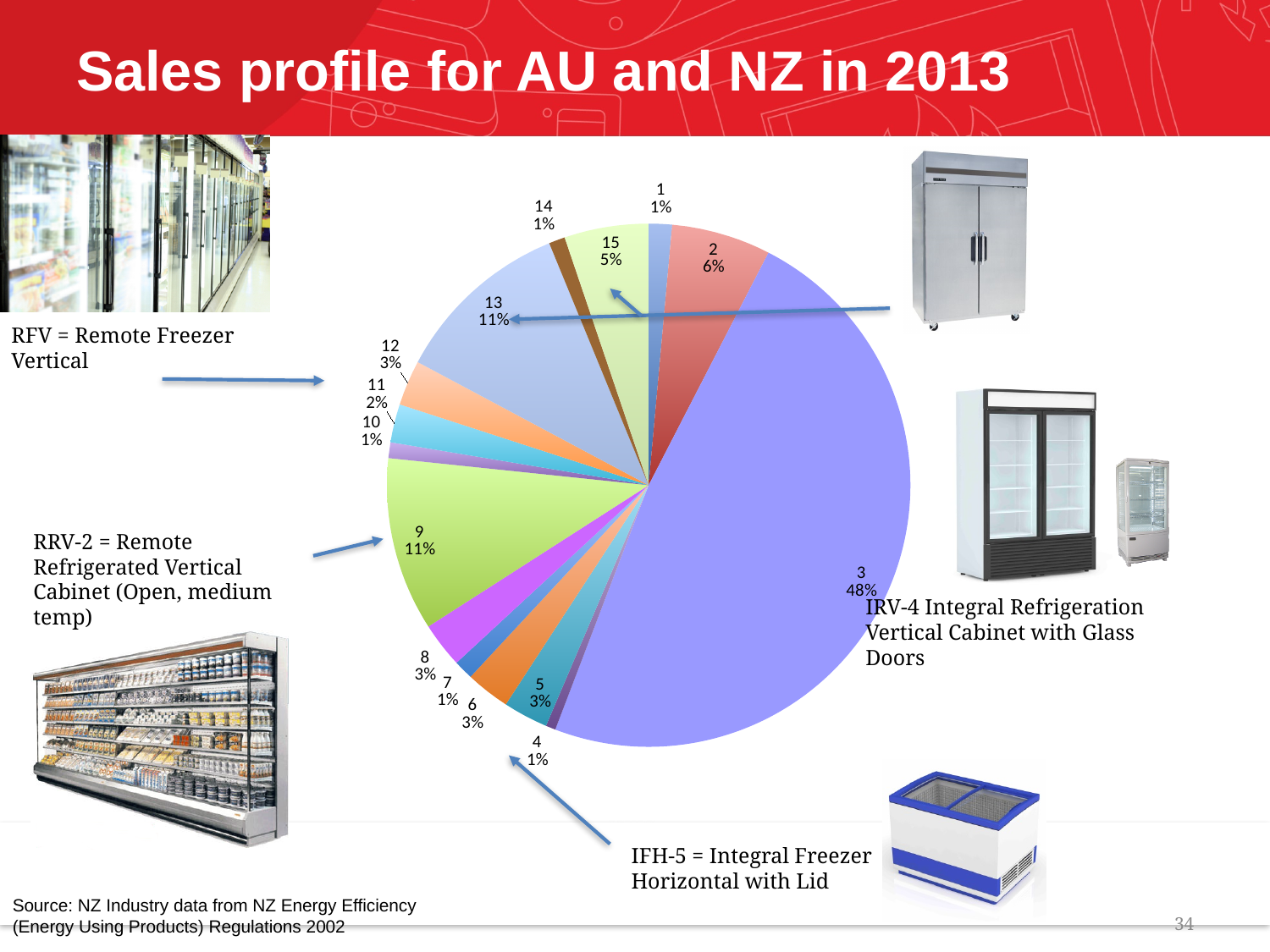
Which is larger in the pie chart, category 13 or category 12? 13 What is the value shown for category 15 in the pie chart? 5% Which category has the largest share of the pie chart? 3 What is the value shown for category 11 in the pie chart? 2% What is the value shown for category 9 in the pie chart? 11% What is the value shown for category 2 in the pie chart? 6% How many slices does the pie chart have? 15 What is the difference in percentage points between category 2 and category 15? 1 What share of the pie does category 3 represent? 48% What is the title of the slide containing the pie chart? Sales profile for AU and NZ in 2013 What is the difference in percentage points between category 3 and category 9? 37 What kind of chart is shown on the slide? pie chart